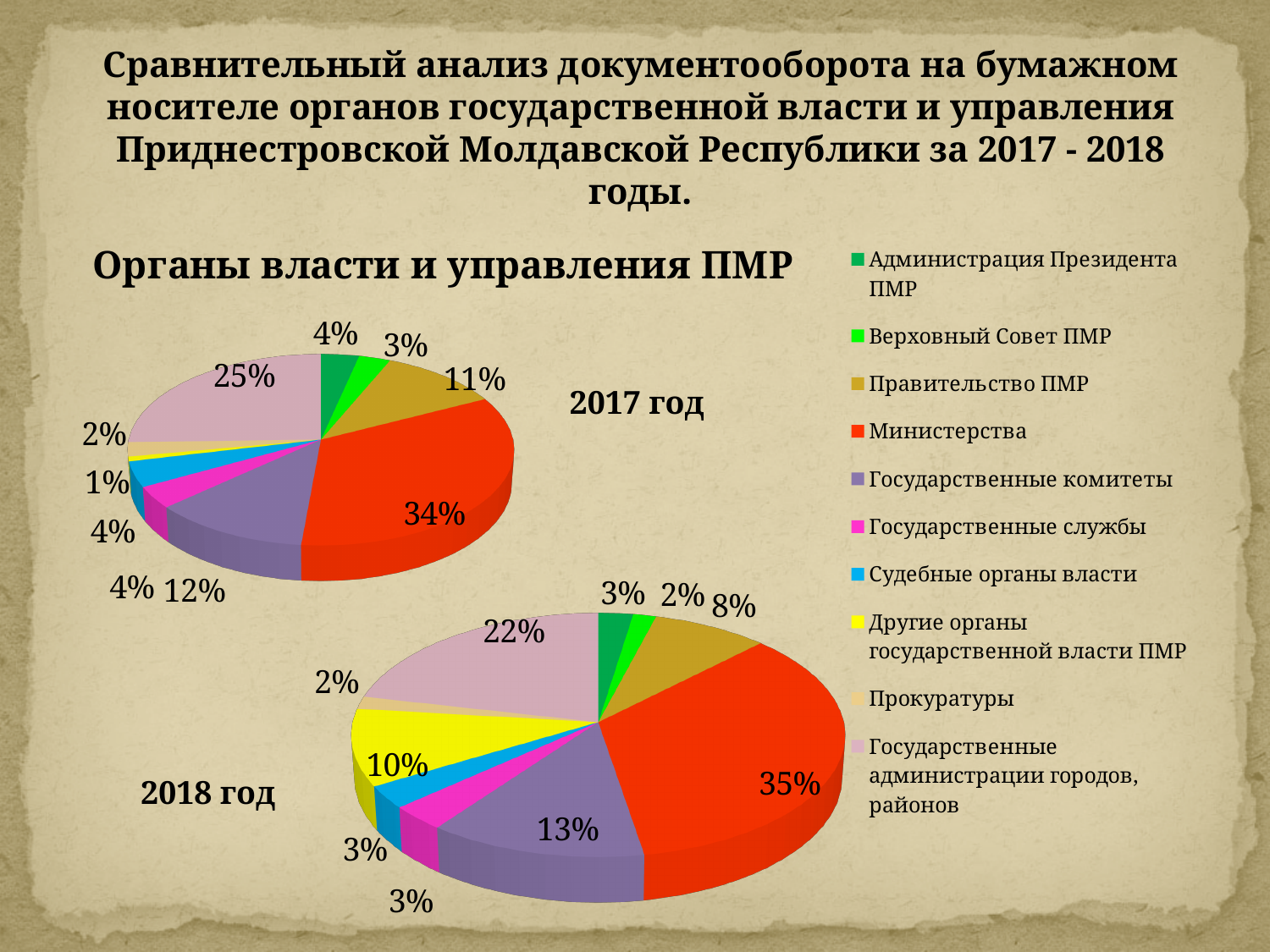
In the 2017 год pie chart, which category has the smallest share? Другие органы государственной власти ПМР In the 2017 год pie chart, what share do Государственные администрации городов, районов have? 25% In the 2018 год pie chart, what share do Другие органы государственной власти ПМР have? 10% In the 2017 год pie chart, which category has the largest share? Министерства In the 2018 год pie chart, which is larger: the share of Правительство ПМР or the share of Другие органы государственной власти ПМР? Другие органы государственной власти ПМР How many entries does the legend list? 10 What kind of charts are shown on the slide? Pie charts In the 2018 год pie chart, what is the difference between the shares of Министерства and Государственные комитеты? 22% In the 2017 год pie chart, what share do Министерства have? 34% In the 2017 год pie chart, what share does Правительство ПМР have? 11% What is the title shown above the pie charts? Органы власти и управления ПМР In the 2018 год pie chart, what share do Министерства have? 35%